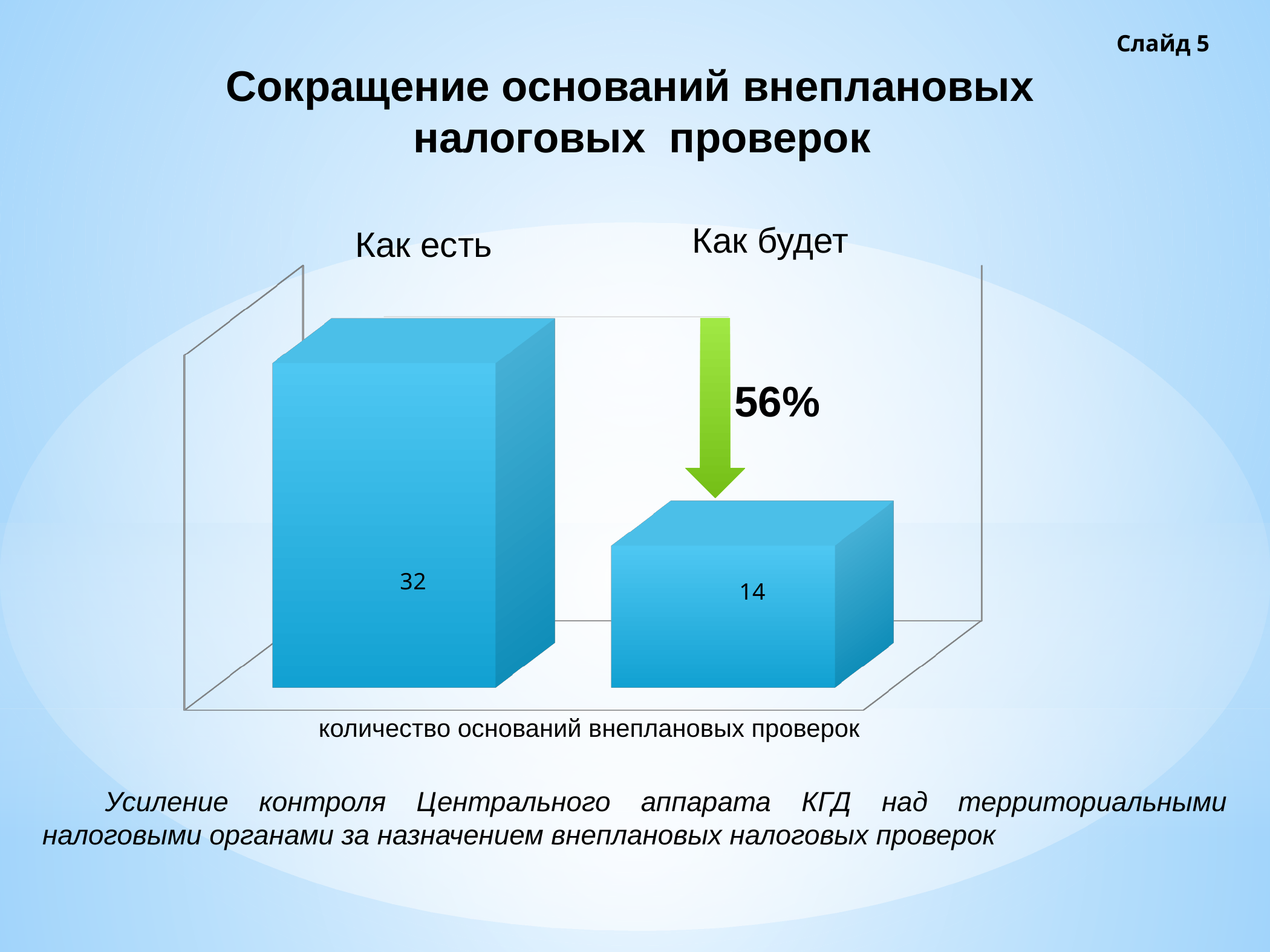
What is the label written below the chart's horizontal axis? количество оснований внеплановых проверок Which category has the higher value, "Как есть" or "Как будет"? Как есть What kind of chart is shown on the slide? bar chart What percentage reduction is shown next to the green arrow? 56% How many bars are shown in the chart? 2 Which category has the lowest value? Как будет Do the values rise or fall from "Как есть" to "Как будет"? fall What is the difference between the values for "Как есть" and "Как будет"? 18 Is the value for "Как будет" larger or smaller than the value for "Как есть"? smaller What is the value for "Как будет"? 14 What is the value for "Как есть"? 32